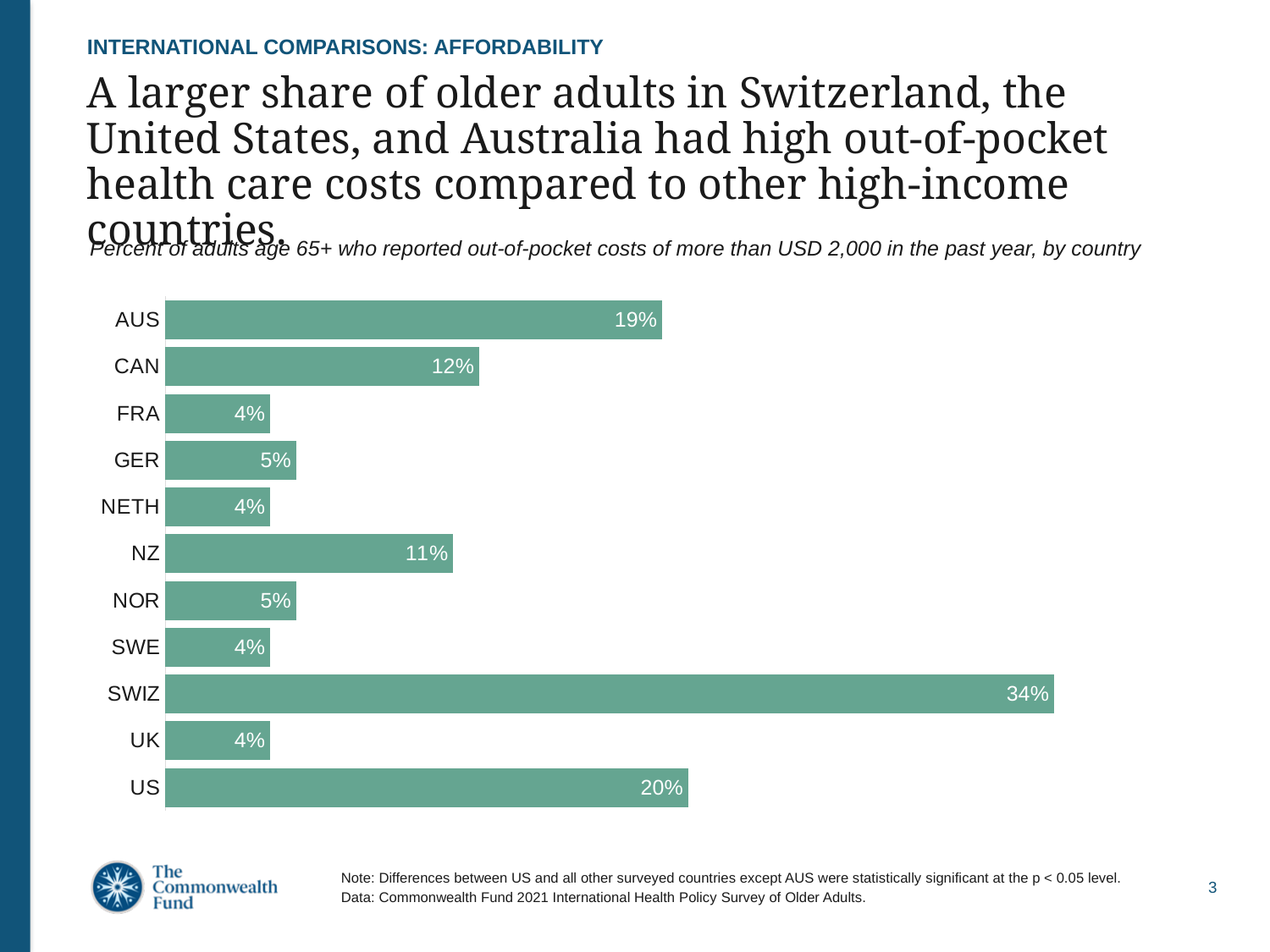
What is the value for CAN? 12% What is the value for UK? 4% Which country has the highest value? SWIZ What is the value for NZ? 11% What is the difference between the values for AUS and CAN? 7% Which is larger, the value for CAN or the value for NZ? CAN How many countries are shown in the chart? 11 What is the value for GER? 5% What is the difference between the values for SWIZ and US? 14% Which is larger, the value for US or the value for AUS? US What kind of chart is shown on the slide? bar chart What is the value for SWIZ? 34%